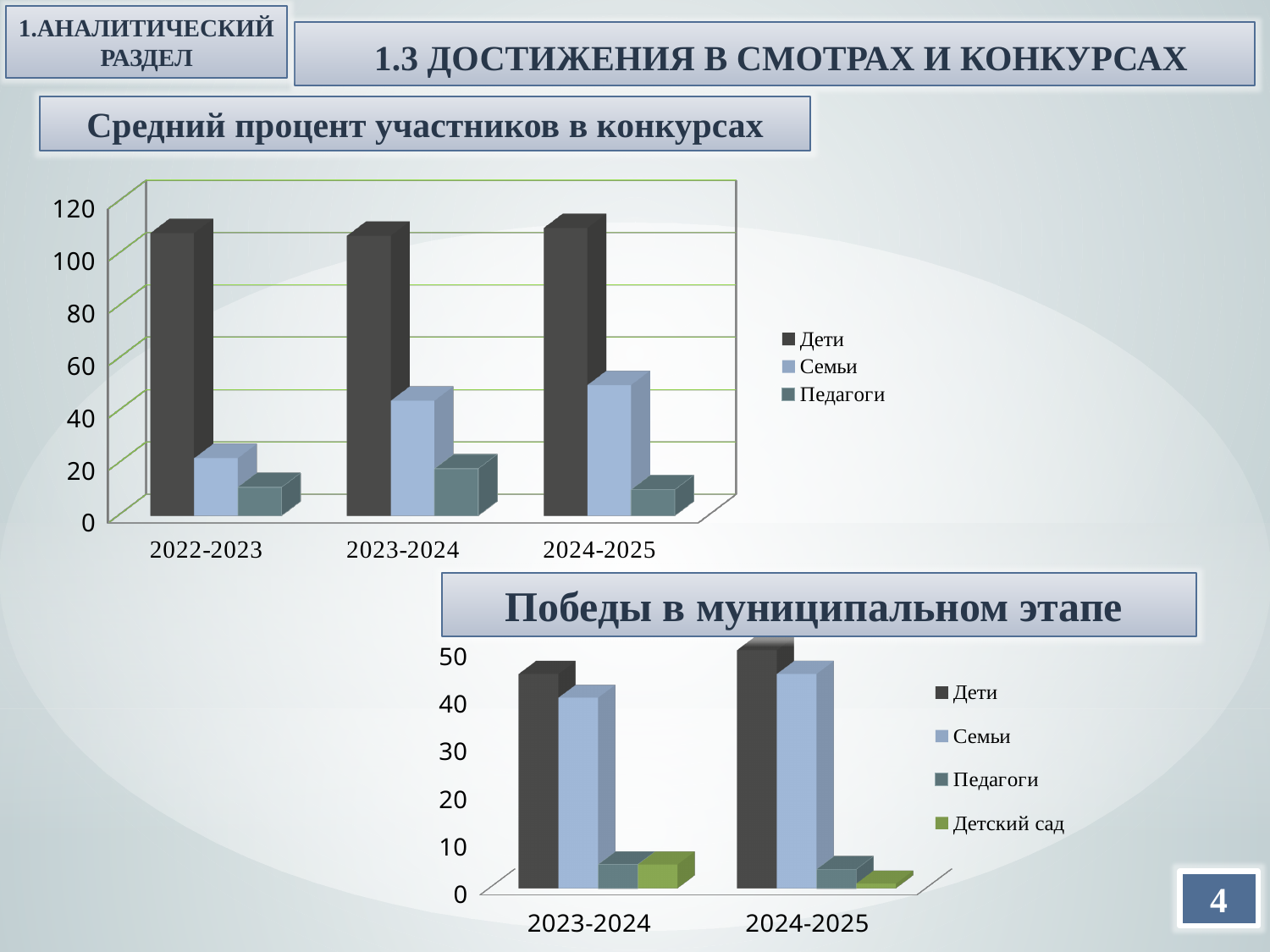
On the chart 'Победы в муниципальном этапе', how many series does the legend list? 4 On the chart 'Средний процент участников в конкурсах', how many series does the legend list? 3 On the chart 'Средний процент участников в конкурсах', does the value for Семьи rise or fall from 2022-2023 to 2024-2025? rise On the chart 'Средний процент участников в конкурсах', which series has the lowest value in 2022-2023? Педагоги On the chart 'Средний процент участников в конкурсах', is the value for Педагоги in 2023-2024 greater or less than 40? less What kind of chart is 'Победы в муниципальном этапе'? bar chart On the chart 'Средний процент участников в конкурсах', is the value for Дети in 2022-2023 greater or less than 100? greater On the chart 'Средний процент участников в конкурсах', which is larger for Семьи: 2022-2023 or 2023-2024? 2023-2024 On the chart 'Средний процент участников в конкурсах', how many categories are shown on the x axis? 3 On the chart 'Средний процент участников в конкурсах', is the value for Семьи in 2022-2023 greater or less than 40? less On the chart 'Победы в муниципальном этапе', which series has the highest value in 2024-2025? Дети